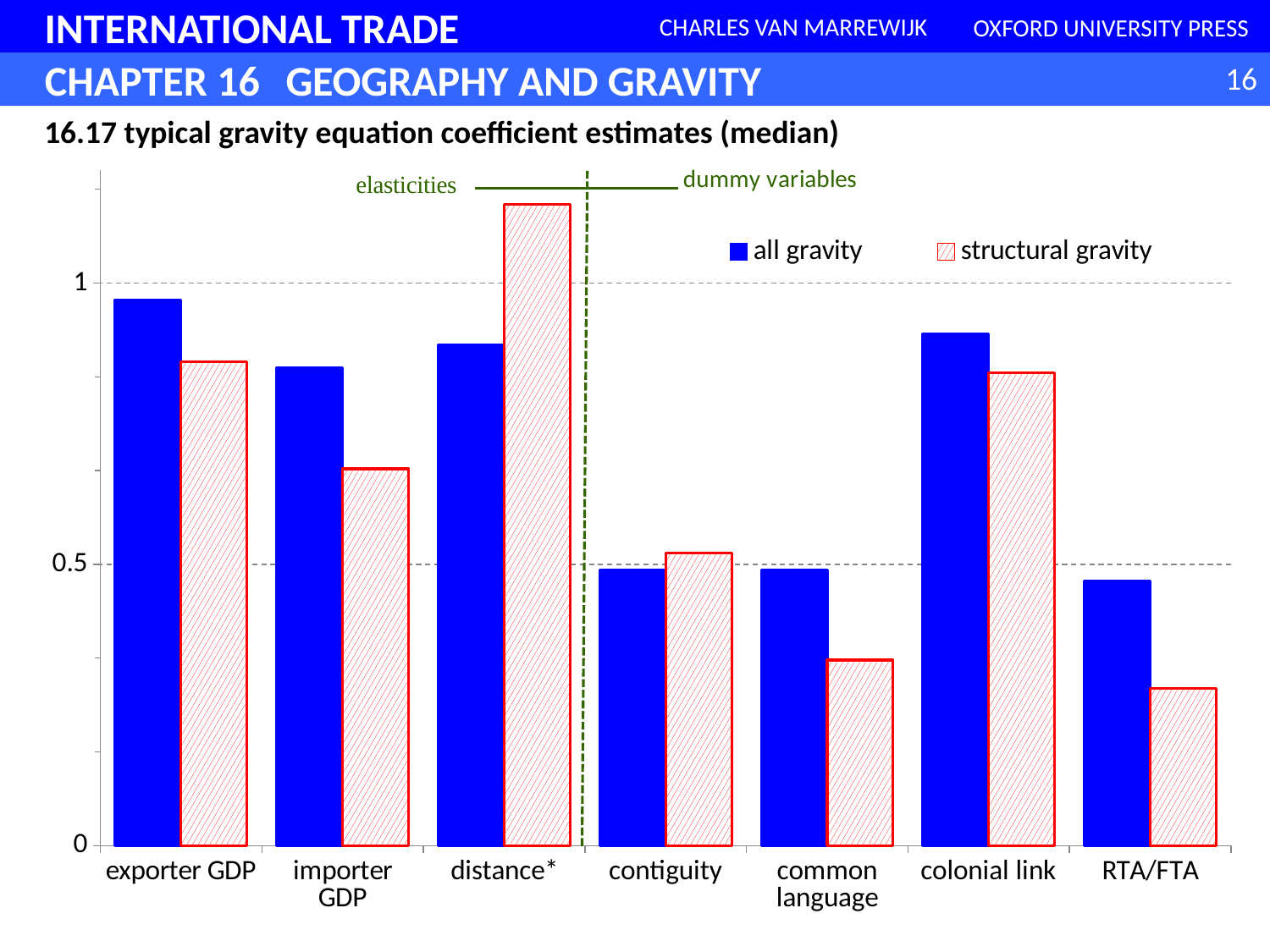
Which category has the highest all gravity value? exporter GDP Is the all gravity value for exporter GDP greater or less than 1? less Is the structural gravity value for distance* greater or less than 1? greater Is the structural gravity value for common language greater or less than 0.5? less For common language, which is larger: the all gravity value or the structural gravity value? all gravity How many categories are shown on the x axis? 7 Which category has the lowest structural gravity value? RTA/FTA How many series does the legend list? 2 For distance*, which is larger: the all gravity value or the structural gravity value? structural gravity Which category has the highest structural gravity value? distance* What kind of chart is shown on the slide? bar chart